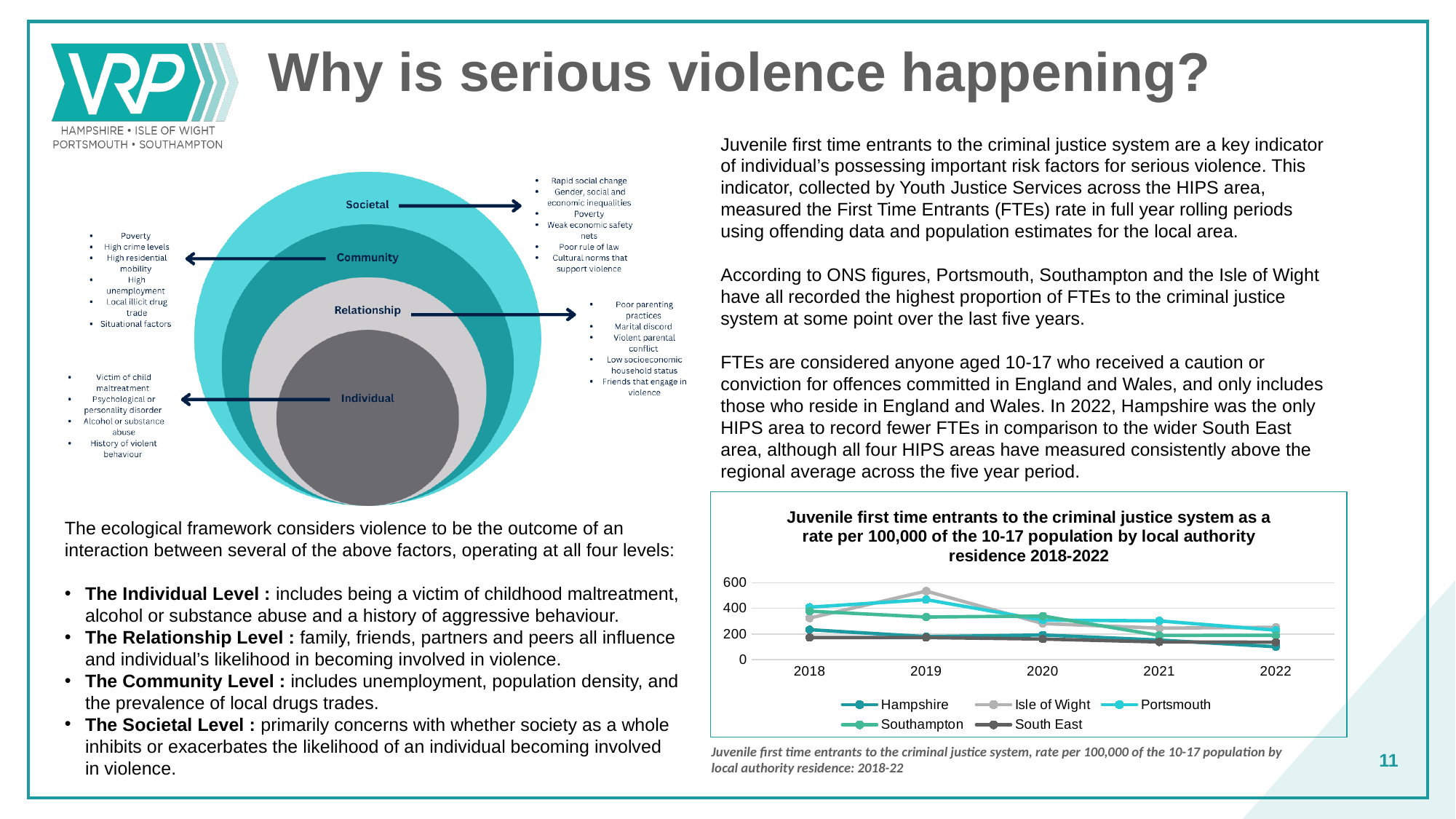
Which series in the chart represents the regional comparison rather than a HIPS local authority? South East In 2021, which is larger: the value for Portsmouth or the value for Hampshire? Portsmouth In 2019, which is larger: the value for Isle of Wight or the value for South East? Isle of Wight Is the value for Southampton in 2020 greater or less than 200? greater What kind of chart is shown on the slide? Line chart Is the value for Hampshire in 2022 greater or less than 200? less Is the value for Isle of Wight in 2019 greater or less than 400? greater How many years are plotted along the x axis of the chart? 5 How many series does the chart legend list? 5 Does the Hampshire line rise or fall from 2018 to 2022? Fall Which local authority has the highest rate in 2019? Isle of Wight